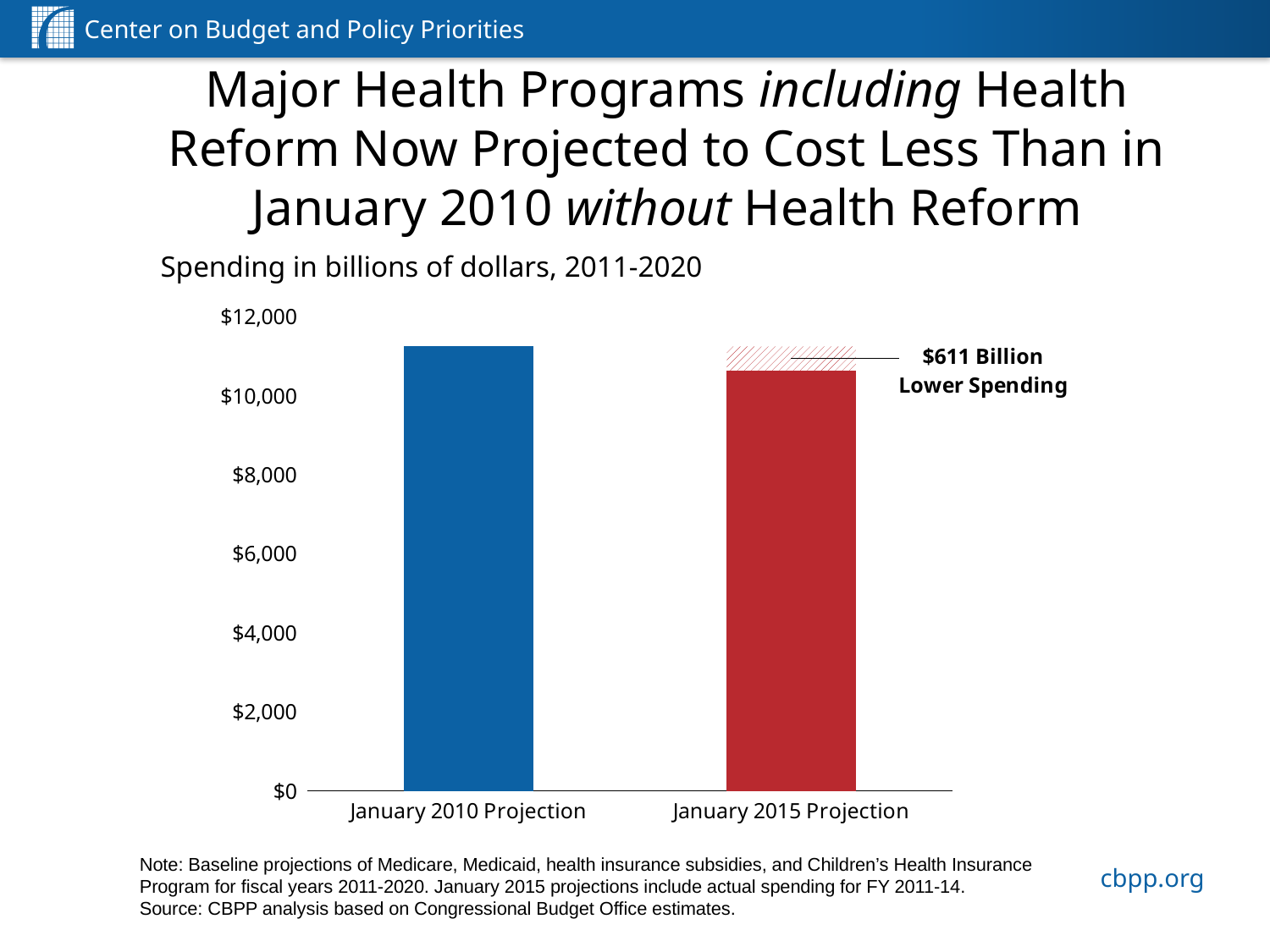
How many bars are plotted in the chart? 2 What does the subtitle say the chart measures? Spending in billions of dollars, 2011-2020 Is the value for the January 2010 Projection greater or less than $10,000? greater Is the value for the January 2015 Projection greater or less than $8,000? greater According to the annotation, how much lower is spending in the January 2015 Projection than in the January 2010 Projection? $611 Billion Is the value for the January 2010 Projection greater or less than $12,000? less What colour is the bar for the January 2015 Projection? Red What kind of chart is shown on the slide? Bar chart Which projection shows the lower spending? January 2015 Projection Which projection shows the higher spending? January 2010 Projection Is the value for the January 2010 Projection larger or smaller than the value for the January 2015 Projection? Larger